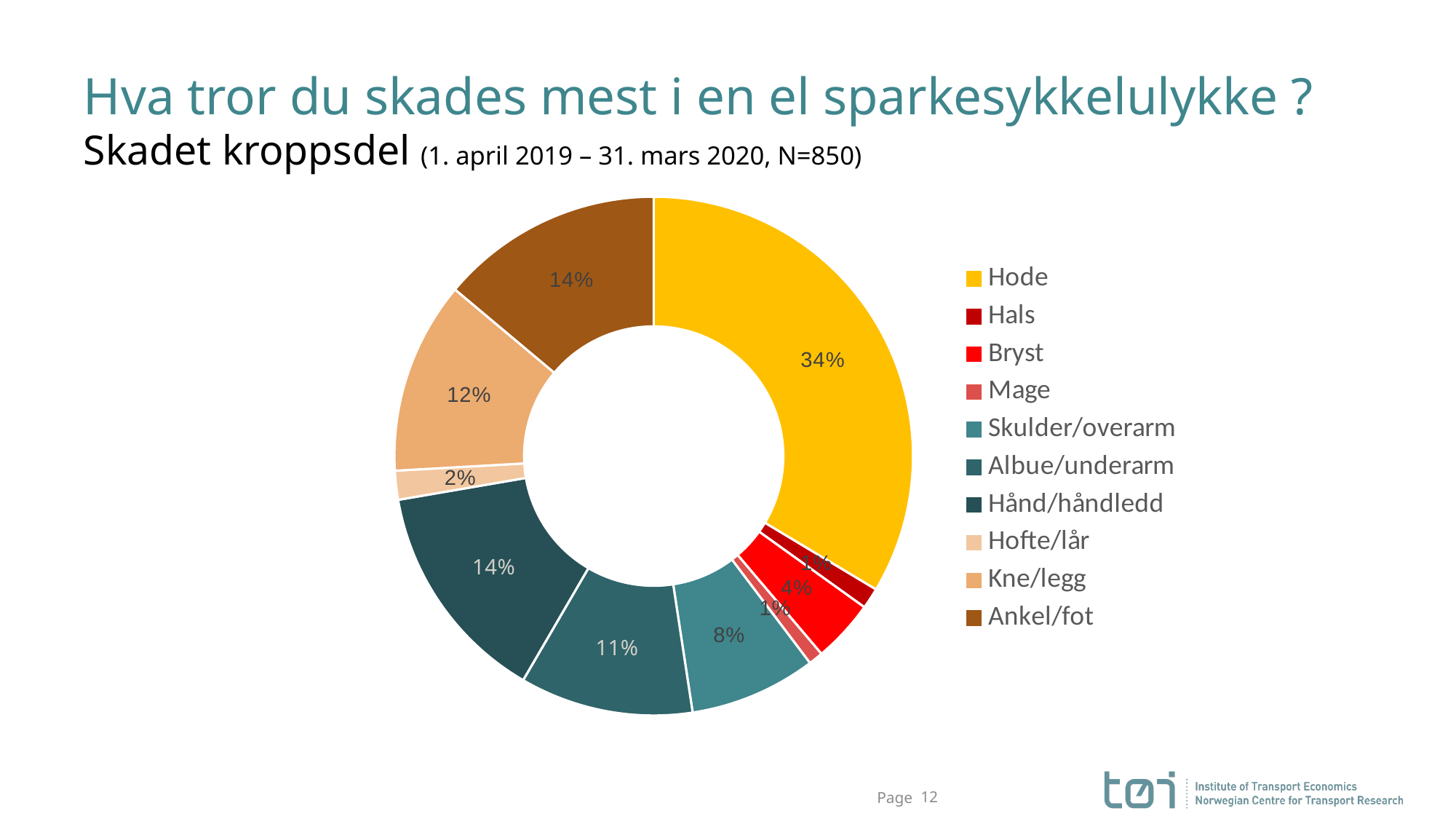
What is the value shown for Hofte/lår? 2% How many categories does the legend list? 10 What share of the pie does Hode account for? 34% What is the value shown for Skulder/overarm? 8% Which category has the largest share of the pie? Hode What is the value shown for Albue/underarm? 11% What is the value shown for Bryst? 4% What colour is the Hode slice in the chart? Yellow What is the difference between the shares for Hode and Hånd/håndledd? 20 percentage points Which is larger, the share for Kne/legg or the share for Skulder/overarm? Kne/legg What kind of chart is shown on the slide? Pie chart (donut) What is the value shown for Kne/legg? 12%